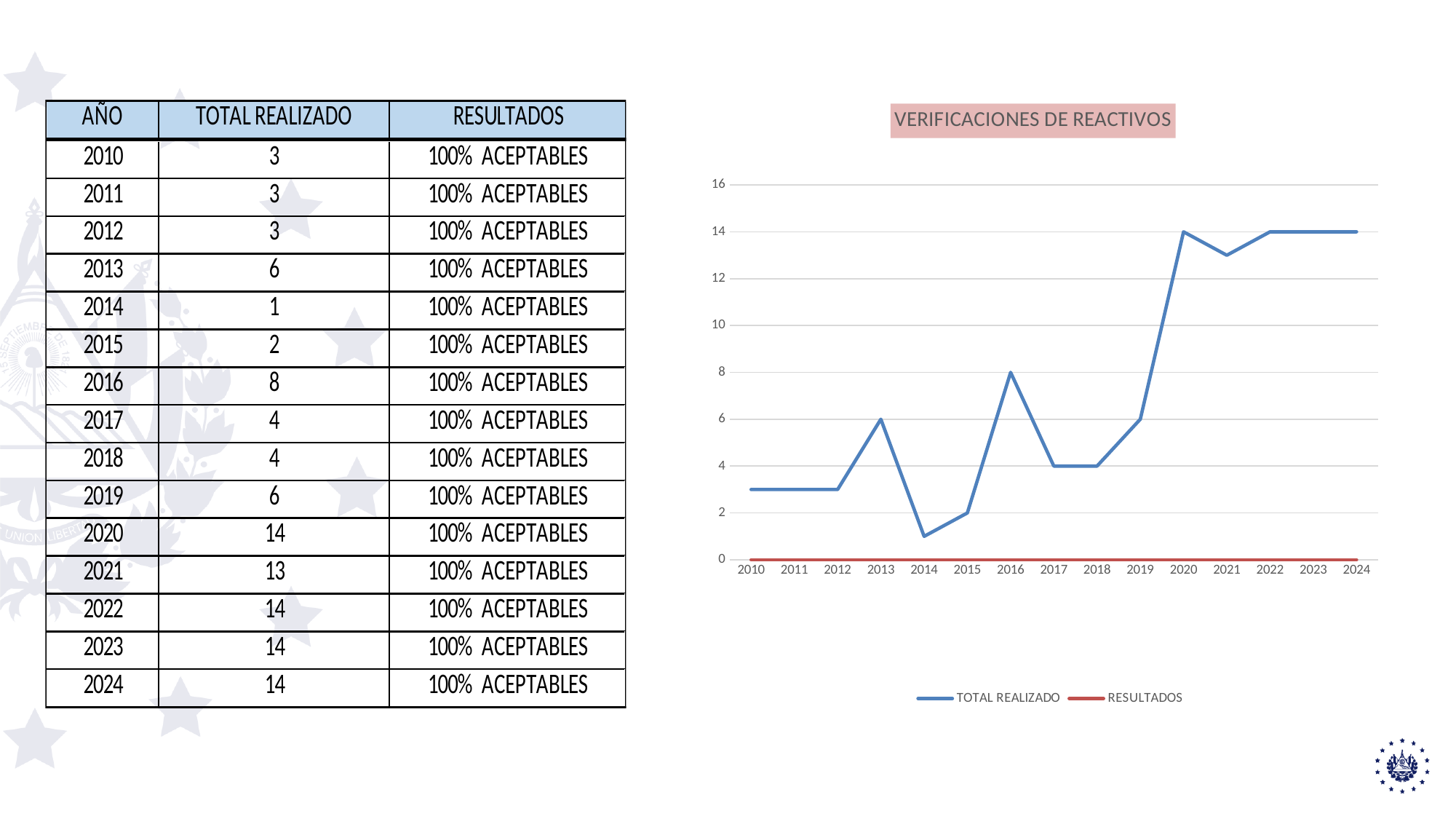
Does the TOTAL REALIZADO line rise or fall between 2019 and 2020? rise How many years are shown on the x axis of the chart? 15 What is the TOTAL REALIZADO value for 2021? 13 How many series does the chart legend list? 2 What is the TOTAL REALIZADO value for 2016? 8 What kind of chart is shown on the slide? line chart What is the difference between the TOTAL REALIZADO values for 2020 and 2019? 8 What is the title of the chart? VERIFICACIONES DE REACTIVOS What is the TOTAL REALIZADO value for 2020? 14 Is the TOTAL REALIZADO value for 2022 greater or less than 10? greater Which year has the lowest TOTAL REALIZADO value? 2014 Which is larger, the TOTAL REALIZADO value for 2013 or for 2015? 2013